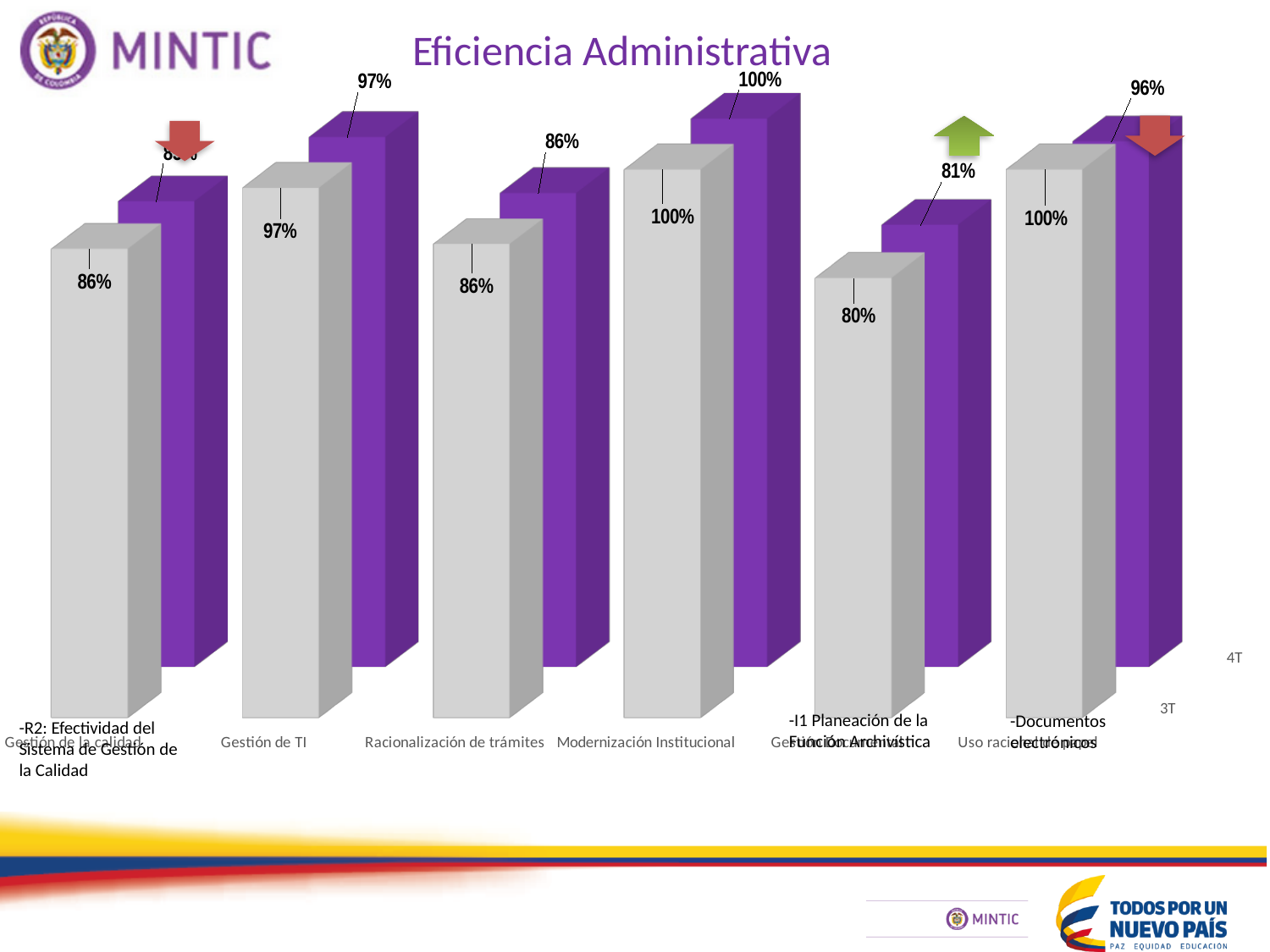
What is the 3T value for Racionalización de trámites? 86% What is the 4T value for the rightmost category? 96% What is the lowest 3T value shown in the chart? 80% What is the 3T value for the fifth category from the left? 80% What is the 4T value for the fifth category from the left? 81% What is the 3T value for Gestión de TI? 97% What is the title of the chart? Eficiencia Administrativa What is the 4T value for Modernización Institucional? 100% How many categories are shown along the x axis of the chart? 6 For the rightmost category, what is the difference between the 3T value and the 4T value? 4% What kind of chart is shown on the slide? bar chart What is the 3T value for the rightmost category? 100%